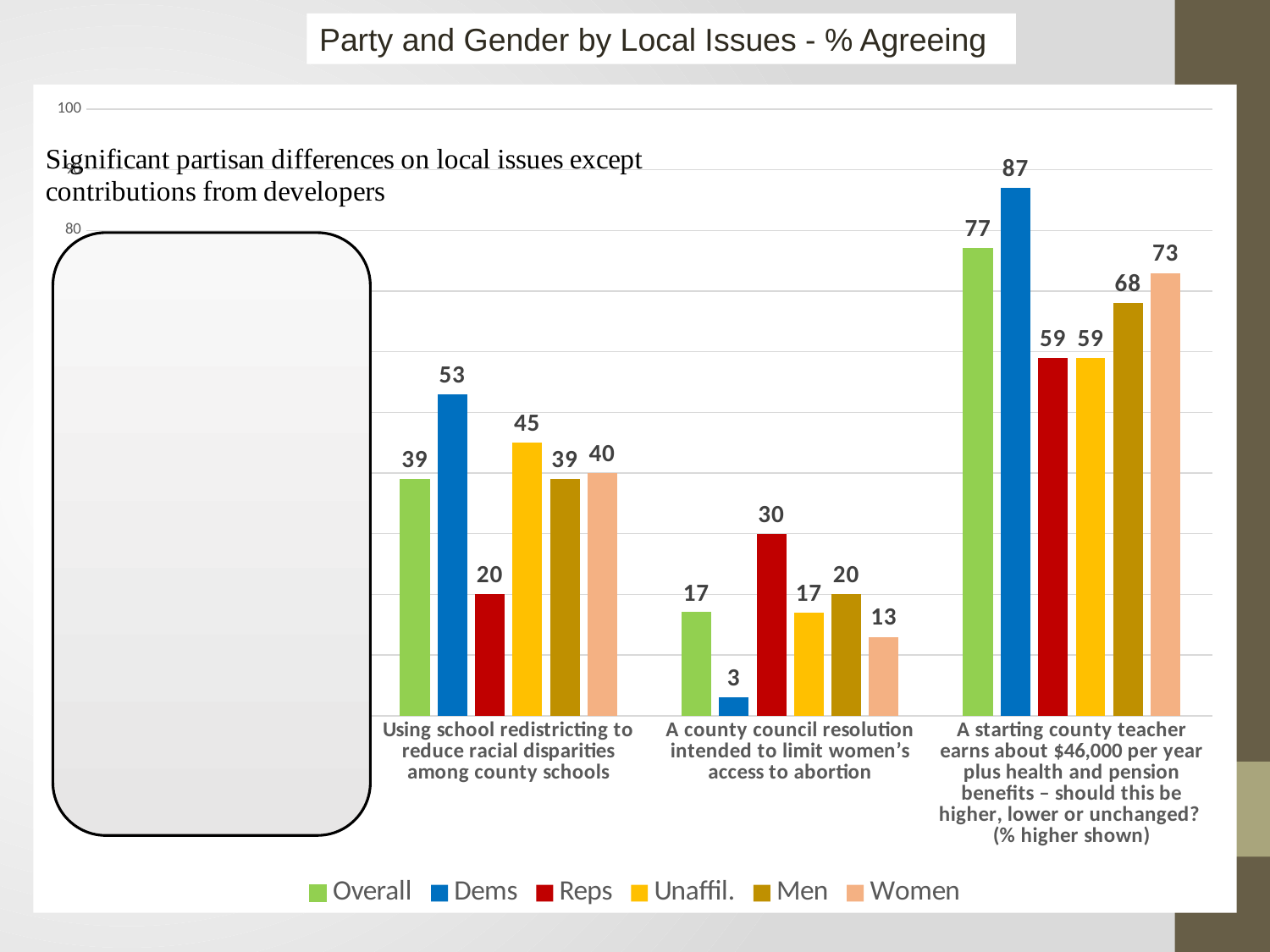
What kind of chart is shown on the slide? Bar chart What is the difference between the Dems and Overall values on the starting county teacher pay issue? 10 What is the value for Women on the starting county teacher pay issue? 73 What is the value for Reps on the county council resolution to limit women's access to abortion? 30 What is the difference between the Dems and Reps values on the school redistricting issue? 33 Is the value for Men on the starting county teacher pay issue greater or less than 60? greater How many series does the legend list? 6 Which group has the highest value on the starting county teacher pay issue? Dems What is the value for Dems on the school redistricting issue? 53 What is the title of the chart? Party and Gender by Local Issues - % Agreeing On the school redistricting issue, which is larger: the value for Unaffil. or the value for Men? Unaffil. Which group has the lowest value on the county council resolution to limit women's access to abortion? Dems